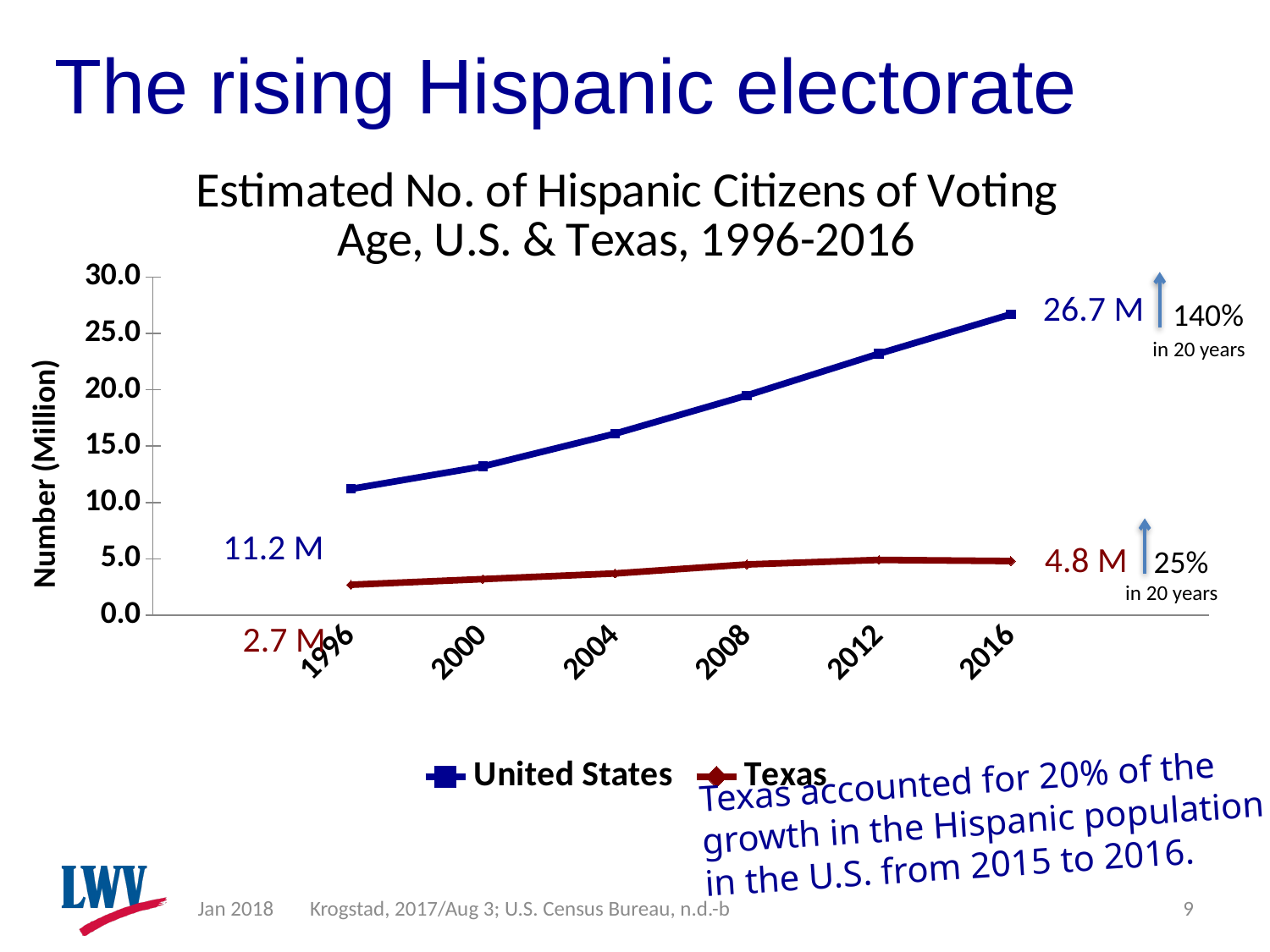
How does the United States series change from 1996 to 2016? It rises What is the estimated number of Hispanic citizens of voting age in Texas in 1996? 2.7 M What kind of chart is shown on the slide? line chart By how much did the Texas value increase from 1996 to 2016? 2.1 M What is the label on the vertical axis of the chart? Number (Million) What is the estimated number of Hispanic citizens of voting age in the United States in 2016? 26.7 M Which series has the larger value in 2016, United States or Texas? United States What is the estimated number of Hispanic citizens of voting age in Texas in 2016? 4.8 M Is the value for the United States in 2012 greater or less than 20.0? greater What is the estimated number of Hispanic citizens of voting age in the United States in 1996? 11.2 M By how much did the United States value increase from 1996 to 2016? 15.5 M How many series does the chart legend list? 2